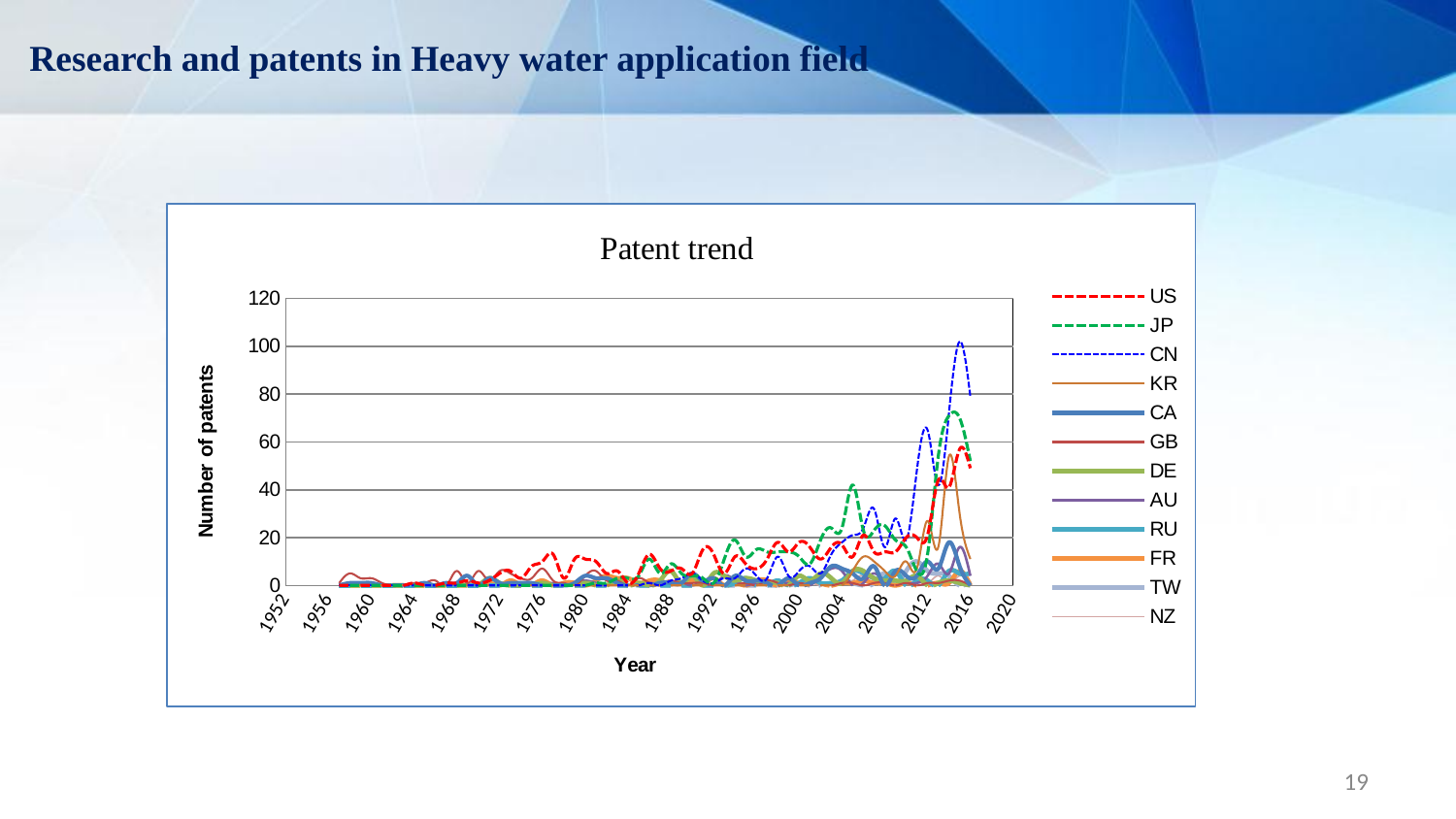
Is the peak value for US greater or less than 80? less What type of chart is shown on the slide? line chart Is the peak value for JP greater or less than 60? greater What is the title of the chart? Patent trend Is the peak value for KR greater or less than 20? greater How many series does the legend list? 12 Which series has a higher peak, CN or JP? CN What is the label of the vertical axis? Number of patents What is the maximum value shown on the vertical axis? 120 Which series reaches the highest peak value on the chart? CN Overall, do the number of patents rise or fall along the x axis from 1952 to 2016? rise